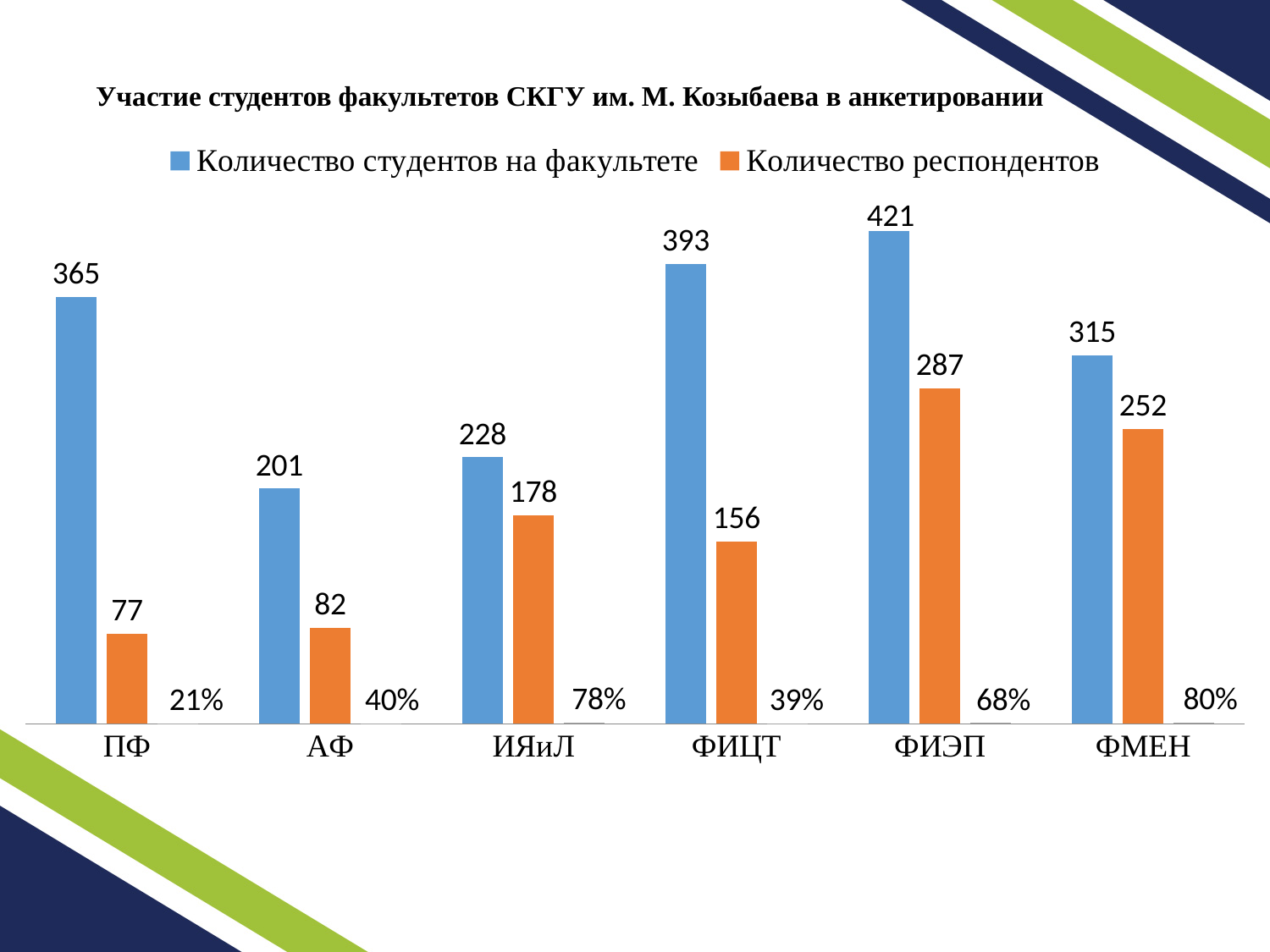
Which faculty has the lowest value for "Количество респондентов"? ПФ Which is larger: "Количество респондентов" for ФИЭП or for ФИЦТ? ФИЭП What is the value of "Количество студентов на факультете" for ФИЦТ? 393 Which faculty has the highest value for "Количество студентов на факультете"? ФИЭП What kind of chart is shown on the slide? Bar chart What colour are the bars for "Количество респондентов"? Orange What is the difference between "Количество студентов на факультете" and "Количество респондентов" for ФМЕН? 63 How many series does the legend list? 2 What percentage is shown for ФМЕН? 80% What is the value of "Количество респондентов" for ИЯиЛ? 178 Which faculty has the lowest percentage label? ПФ How many faculties are shown on the x axis? 6